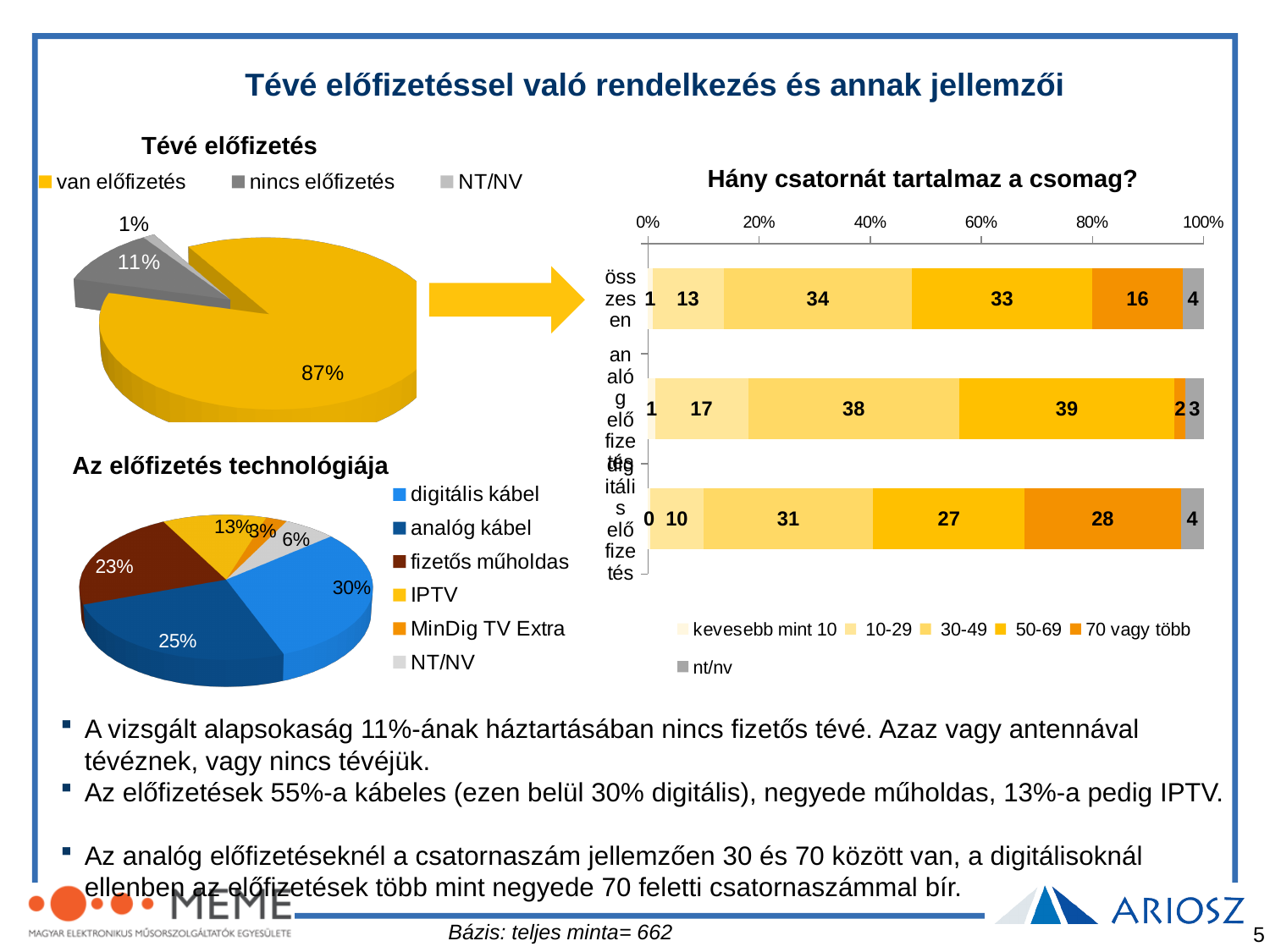
In the 'Az előfizetés technológiája' pie chart, what share is 'IPTV'? 13% In the 'Az előfizetés technológiája' pie chart, what share is 'digitális kábel'? 30% In the 'Hány csatornát tartalmaz a csomag?' chart, which is larger for 'analóg előfizetés': '30-49' or '50-69'? 50-69 How many series does the legend of 'Hány csatornát tartalmaz a csomag?' list? 6 In the 'Az előfizetés technológiája' pie chart, how many categories does the legend list? 6 In the 'Tévé előfizetés' pie chart, which category has the smallest slice? NT/NV In the 'Tévé előfizetés' pie chart, what share is 'nincs előfizetés'? 11% In the 'Hány csatornát tartalmaz a csomag?' chart, what is the value of '70 vagy több' for 'digitális előfizetés'? 28 In the 'Az előfizetés technológiája' pie chart, what is the difference between 'analóg kábel' and 'fizetős műholdas'? 2% In the 'Tévé előfizetés' pie chart, what share is 'van előfizetés'? 87% What kind of chart is 'Hány csatornát tartalmaz a csomag?'? stacked bar chart In the 'Hány csatornát tartalmaz a csomag?' chart, what is the value of '30-49' for 'összesen'? 34